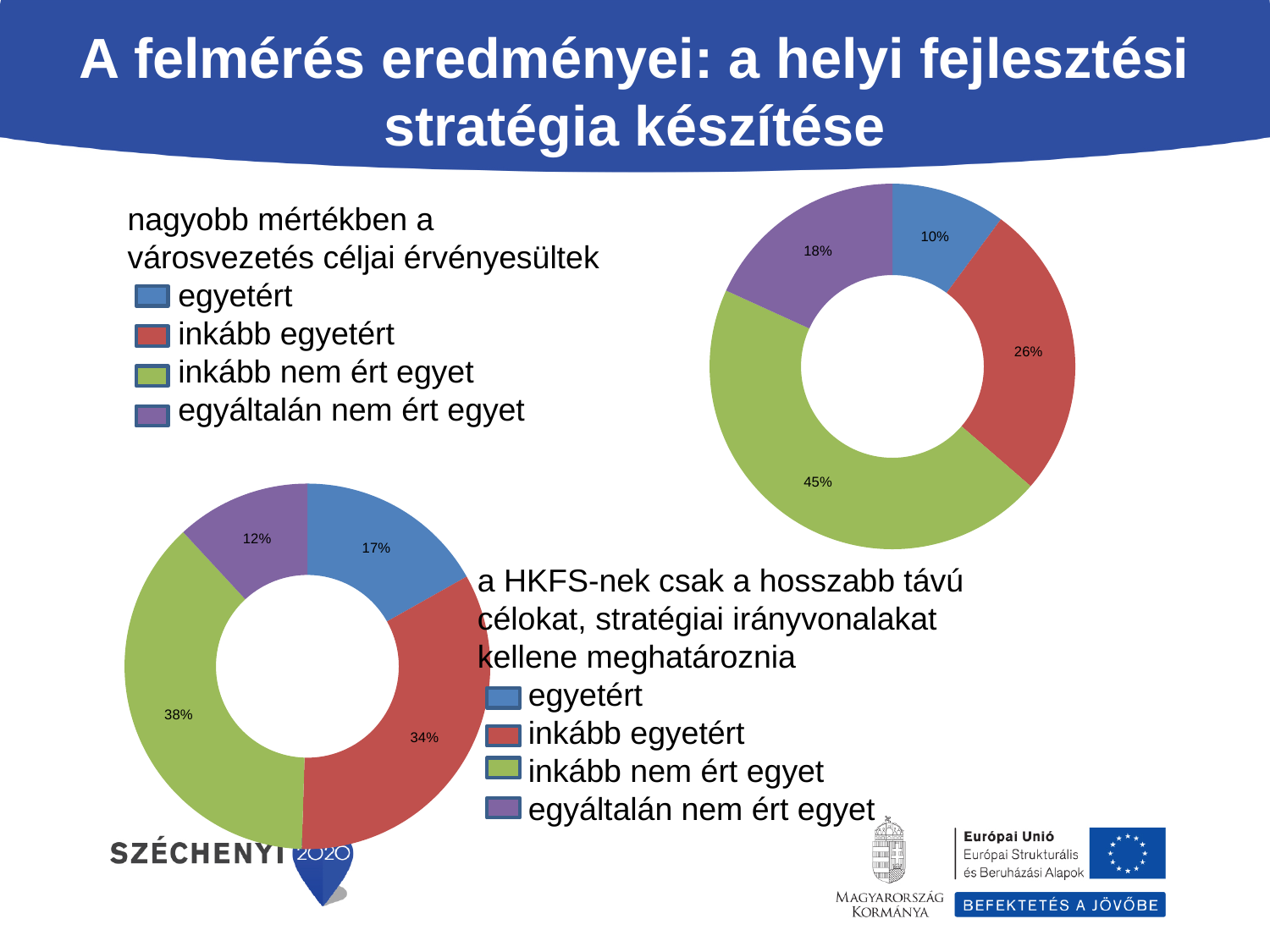
In the top-right chart (nagyobb mértékben a városvezetés céljai érvényesültek), what share of respondents chose 'egyetért'? 10% In the bottom-left chart (a HKFS-nek csak a hosszabb távú célokat kellene meghatároznia), what share of respondents chose 'inkább egyetért'? 34% In the top-right chart (nagyobb mértékben a városvezetés céljai érvényesültek), what is the difference in percentage points between 'inkább egyetért' and 'egyáltalán nem ért egyet'? 8 percentage points In the top-right chart (nagyobb mértékben a városvezetés céljai érvényesültek), which response category has the smallest share? egyetért How many response categories does the legend of the top-right chart list? 4 In the top-right chart (nagyobb mértékben a városvezetés céljai érvényesültek), what share of respondents chose 'inkább nem ért egyet'? 45% What kind of chart is used for the bottom-left chart on the slide? Doughnut (pie) chart In the top-right chart (nagyobb mértékben a városvezetés céljai érvényesültek), which response category has the largest share? inkább nem ért egyet In the bottom-left chart (a HKFS-nek csak a hosszabb távú célokat kellene meghatároznia), what is the difference in percentage points between 'inkább nem ért egyet' and 'inkább egyetért'? 4 percentage points In the bottom-left chart (a HKFS-nek csak a hosszabb távú célokat kellene meghatároznia), what share of respondents chose 'egyáltalán nem ért egyet'? 12% In the bottom-left chart (a HKFS-nek csak a hosszabb távú célokat kellene meghatároznia), which is larger: 'egyetért' or 'egyáltalán nem ért egyet'? egyetért In the bottom-left chart (a HKFS-nek csak a hosszabb távú célokat kellene meghatároznia), which response category has the largest share? inkább nem ért egyet